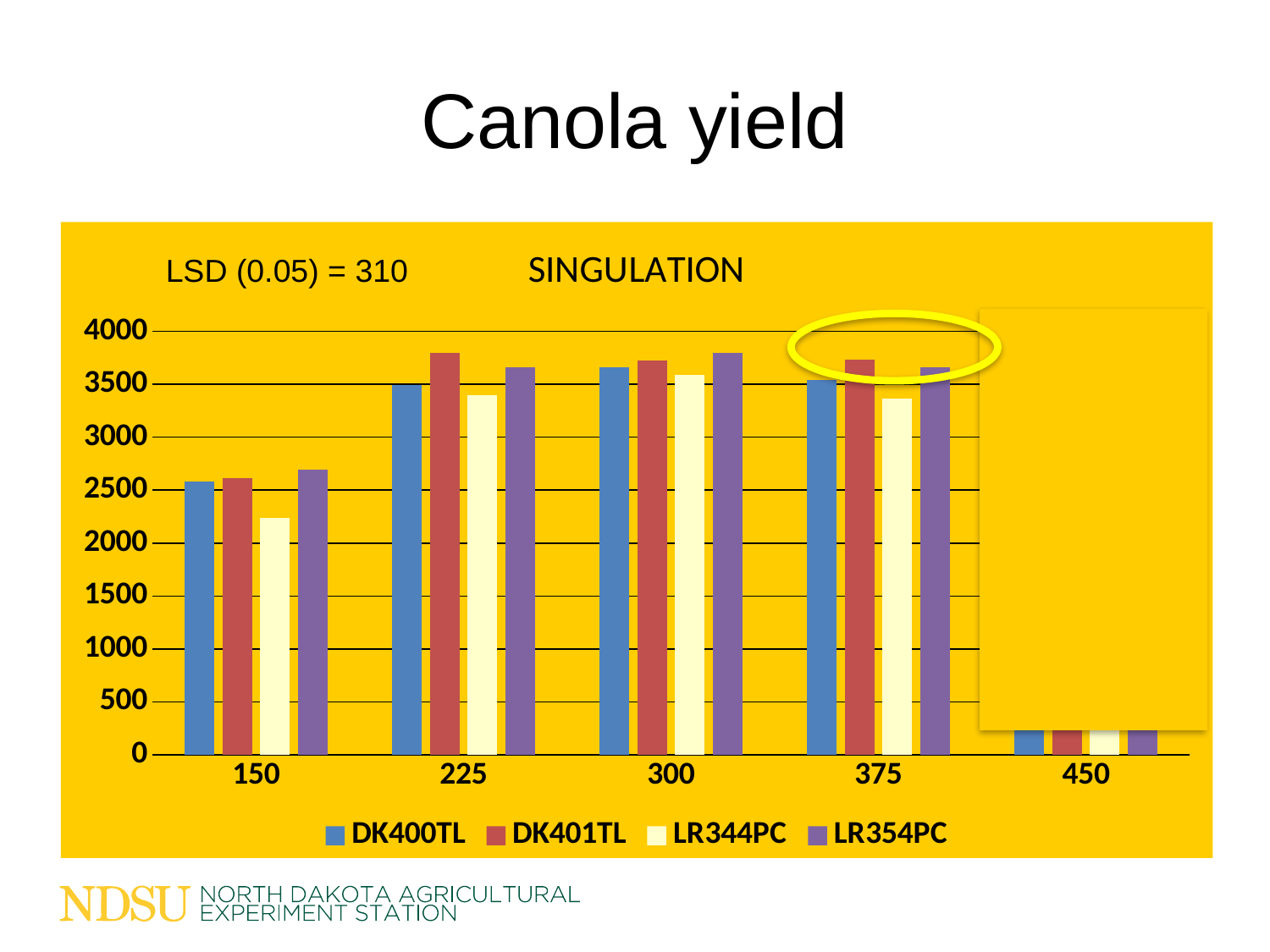
How many series does the legend list? 4 Does the value for DK400TL rise or fall from 150 to 225? rise Which series has the highest value at 225? DK401TL Is the value for LR354PC at 300 greater or less than 3500? greater How many categories are shown on the x axis? 5 Which series has the lowest value at 150? LR344PC Is the value for LR344PC at 150 greater or less than 2500? less What kind of chart is shown on the slide? bar chart Is the value for DK401TL at 225 greater or less than 3500? greater What LSD value is printed on the chart? LSD (0.05) = 310 At 375, which is larger: DK401TL or LR344PC? DK401TL